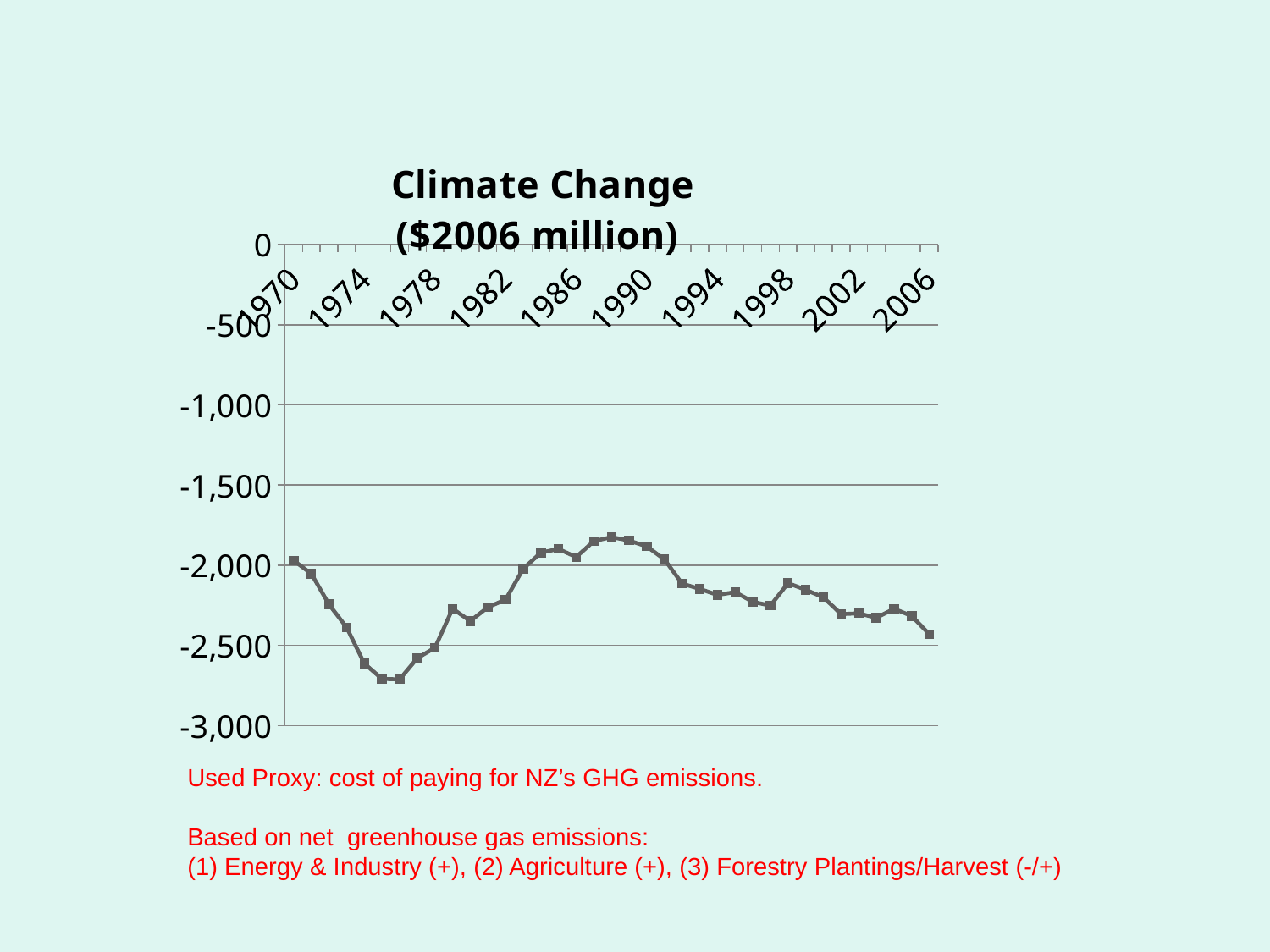
Is the value for 2006 greater or less than -2,000? less Is the value for 1998 greater or less than -2,500? greater Is the value for 1976 greater or less than -2,500? less What kind of chart is shown on the slide? line chart What is the lowest value shown on the y axis of the chart? -3,000 Do the values rise or fall between 1990 and 2006? fall Which year has the larger value, 1970 or 2006? 1970 Do the values rise or fall between 1970 and 1976? fall What is the title of the chart? Climate Change ($2006 million) Which year has the larger value, 1976 or 1990? 1990